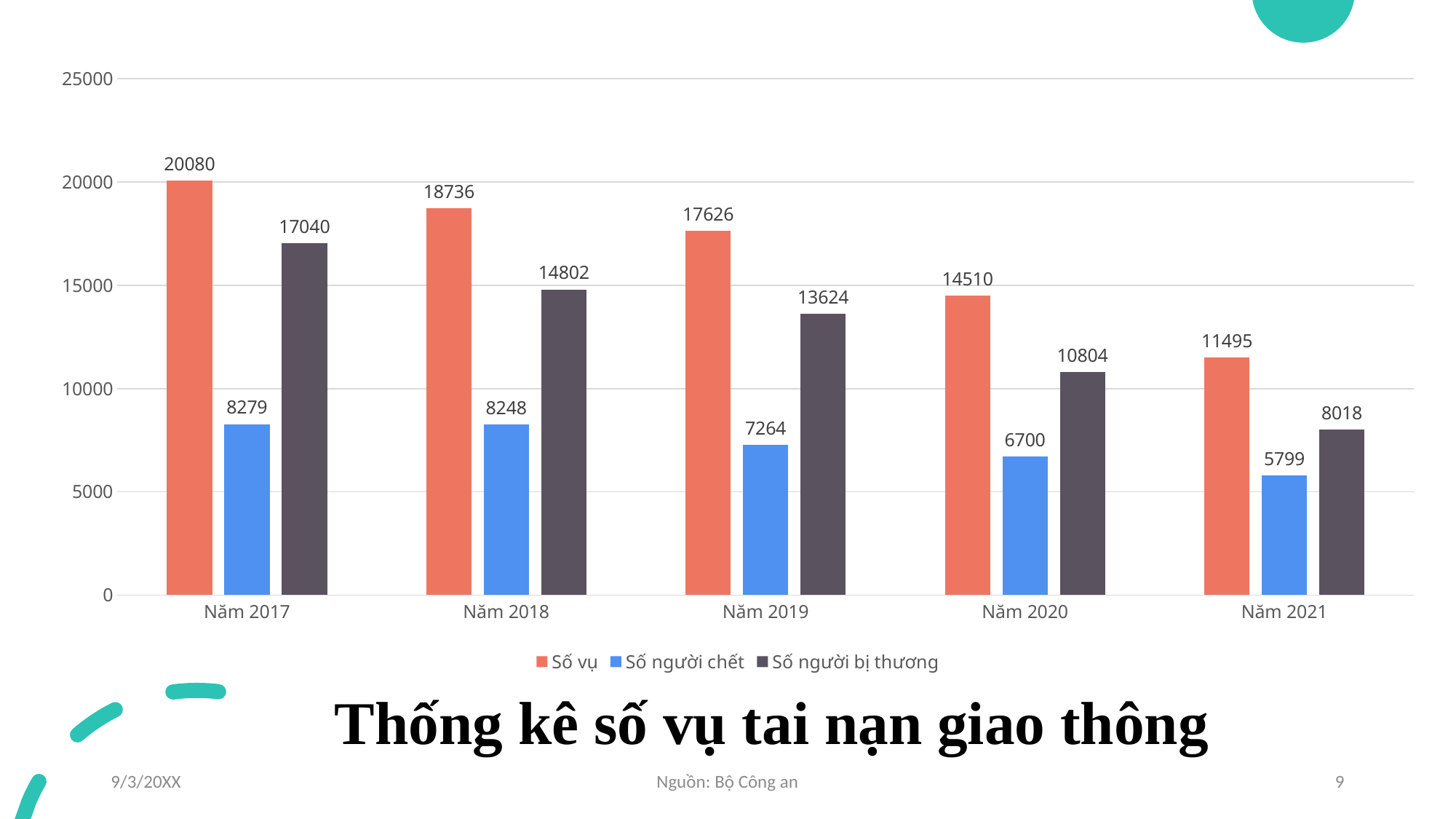
What is the value of Số người chết for Năm 2019? 7264 What kind of chart is shown on the slide? bar chart How many years are shown on the x axis? 5 What is the difference between Số vụ and Số người bị thương in Năm 2020? 3706 What is the value of Số vụ for Năm 2017? 20080 Which year has the lowest value for Số người chết? Năm 2021 What is the value of Số người bị thương for Năm 2021? 8018 How many series does the legend list? 3 Is the value of Số người bị thương for Năm 2019 greater or less than 15000? less Do the values for Số vụ rise or fall from Năm 2017 to Năm 2021? fall Which is larger: Số người chết in Năm 2017 or Số người chết in Năm 2018? Số người chết in Năm 2017 Which year has the highest value for Số vụ? Năm 2017